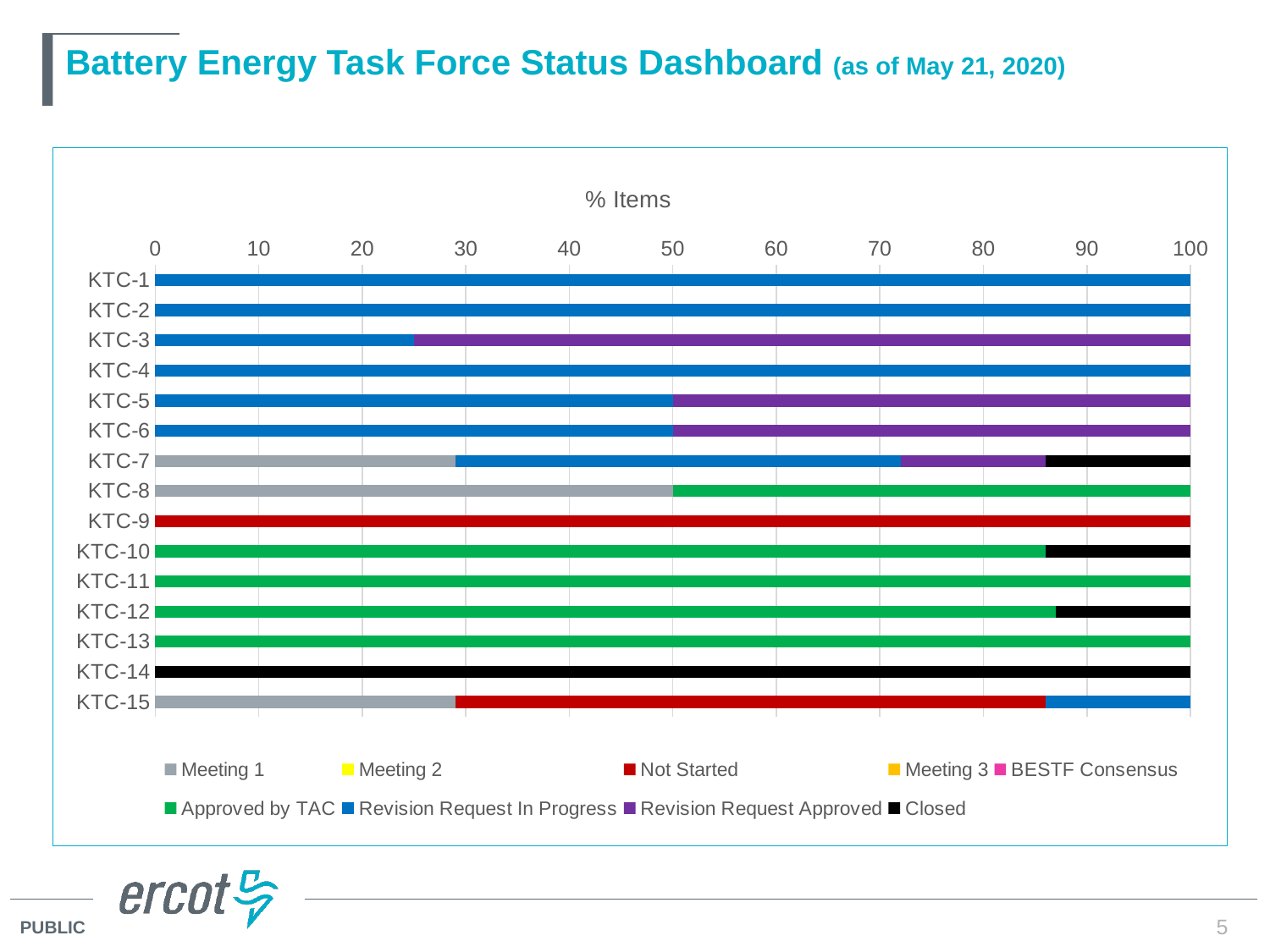
Is the Meeting 1 value for KTC-7 greater or less than 20? greater What is the Revision Request In Progress value for KTC-5? 50 What is the title of the chart? % Items What kind of chart is shown on the slide? bar chart What is the Not Started value for KTC-9? 100 What is the Closed value for KTC-14? 100 How many KTC categories are plotted on the chart? 15 Which series is shown in black in the legend? Closed Is the Revision Request In Progress value for KTC-3 greater or less than 30? less Which has the larger Revision Request In Progress value, KTC-3 or KTC-5? KTC-5 What is the Meeting 1 value for KTC-8? 50 How many series does the chart legend list? 9